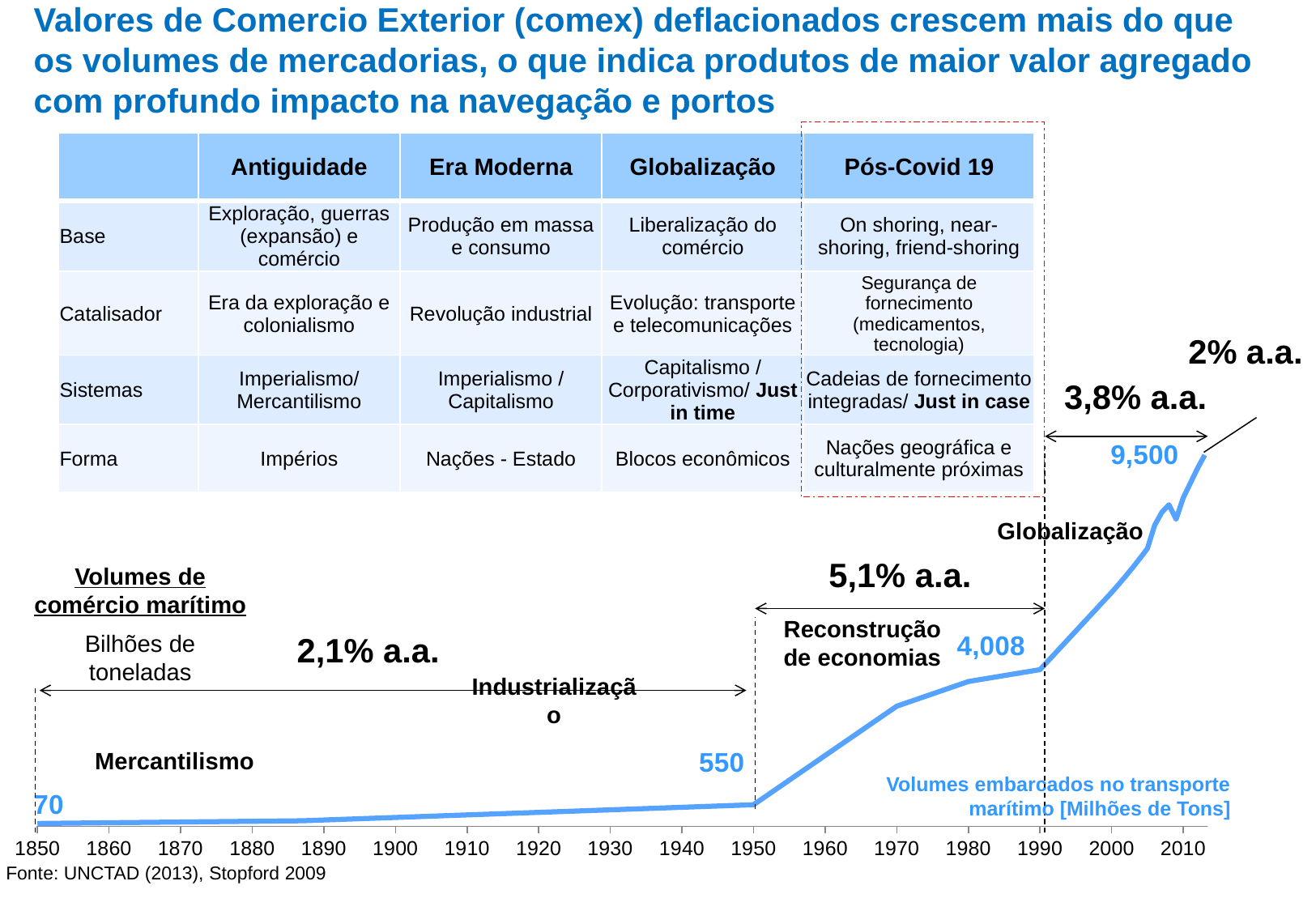
What annual growth rate is shown for the period between 1850 and 1950? 2,1% a.a. What is the highest value labelled on the line, at the end of the series? 9,500 What is the difference between the values labelled for 1950 and 1850? 480 What annual growth rate is shown for the period between 1950 and 1990? 5,1% a.a. What type of chart is shown at the bottom of the slide? line chart Do the maritime trade volumes rise or fall from 1850 to the end of the series? rise What is the difference between the values labelled for 1990 and 1950? 3,458 What is the maritime trade volume shown for 1850? 70 What is the lowest value labelled on the line? 70 Which is larger, the value labelled for 1950 or the value labelled for 1990? 1990 What is the maritime trade volume shown for 1990? 4,008 What is the maritime trade volume shown for 1950? 550